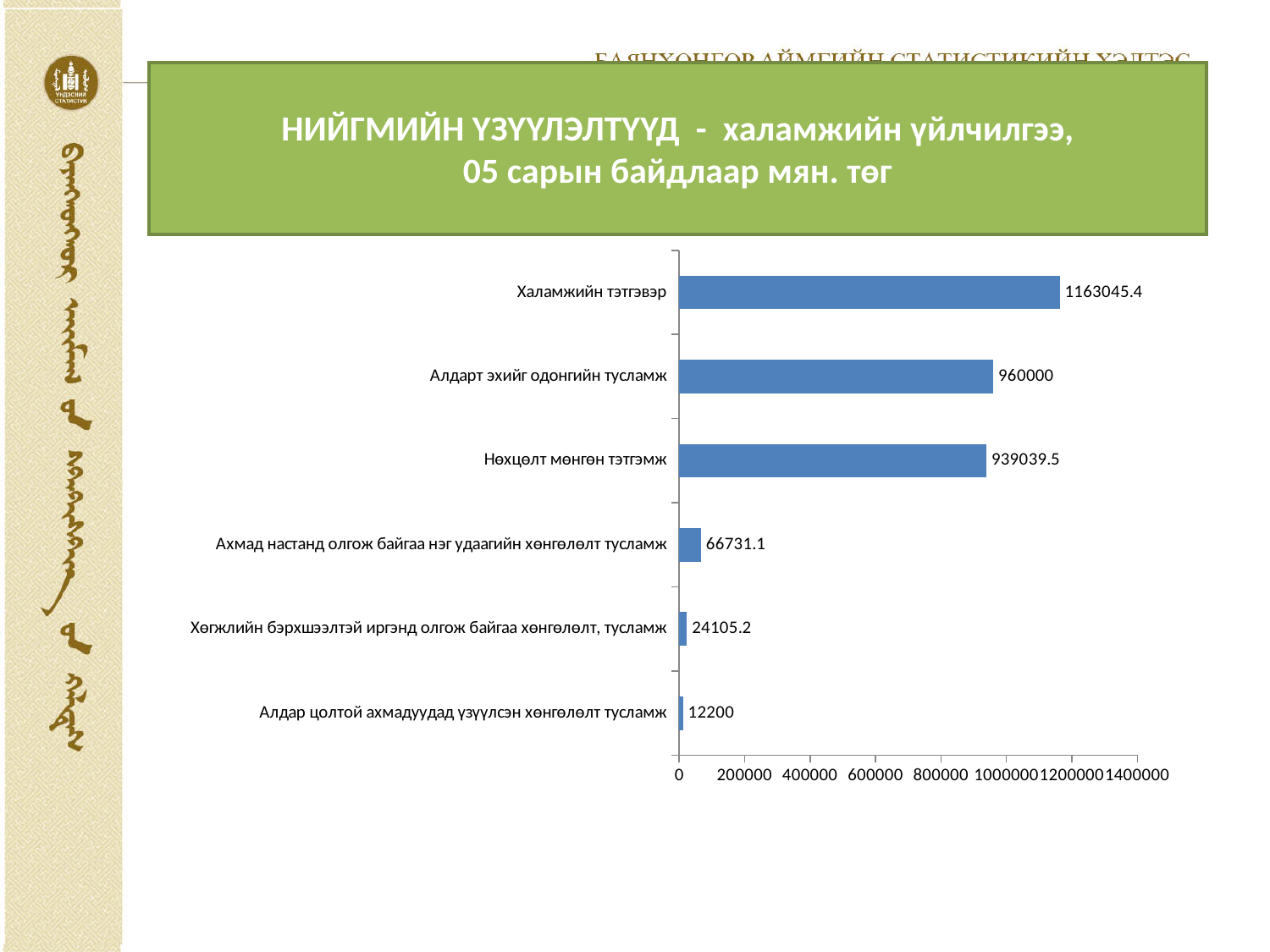
What is the value for Алдар цолтой ахмадуудад үзүүлсэн хөнгөлөлт тусламж? 12200 Which category has the highest value? Халамжийн тэтгэвэр Which category has the lowest value? Алдар цолтой ахмадуудад үзүүлсэн хөнгөлөлт тусламж What kind of chart is shown on the slide? bar chart What is the value for Халамжийн тэтгэвэр? 1163045.4 What is the difference between the values for Халамжийн тэтгэвэр and Алдарт эхийг одонгийн тусламж? 203045.4 Which is larger, the value for Алдарт эхийг одонгийн тусламж or the value for Нөхцөлт мөнгөн тэтгэмж? Алдарт эхийг одонгийн тусламж What is the value for Нөхцөлт мөнгөн тэтгэмж? 939039.5 What is the value for Хөгжлийн бэрхшээлтэй иргэнд олгож байгаа хөнгөлөлт, тусламж? 24105.2 How many categories are shown in the chart? 6 Is the value for Нөхцөлт мөнгөн тэтгэмж greater or less than 800000? greater What is the difference between the values for Ахмад настанд олгож байгаа нэг удаагийн хөнгөлөлт тусламж and Хөгжлийн бэрхшээлтэй иргэнд олгож байгаа хөнгөлөлт, тусламж? 42625.9